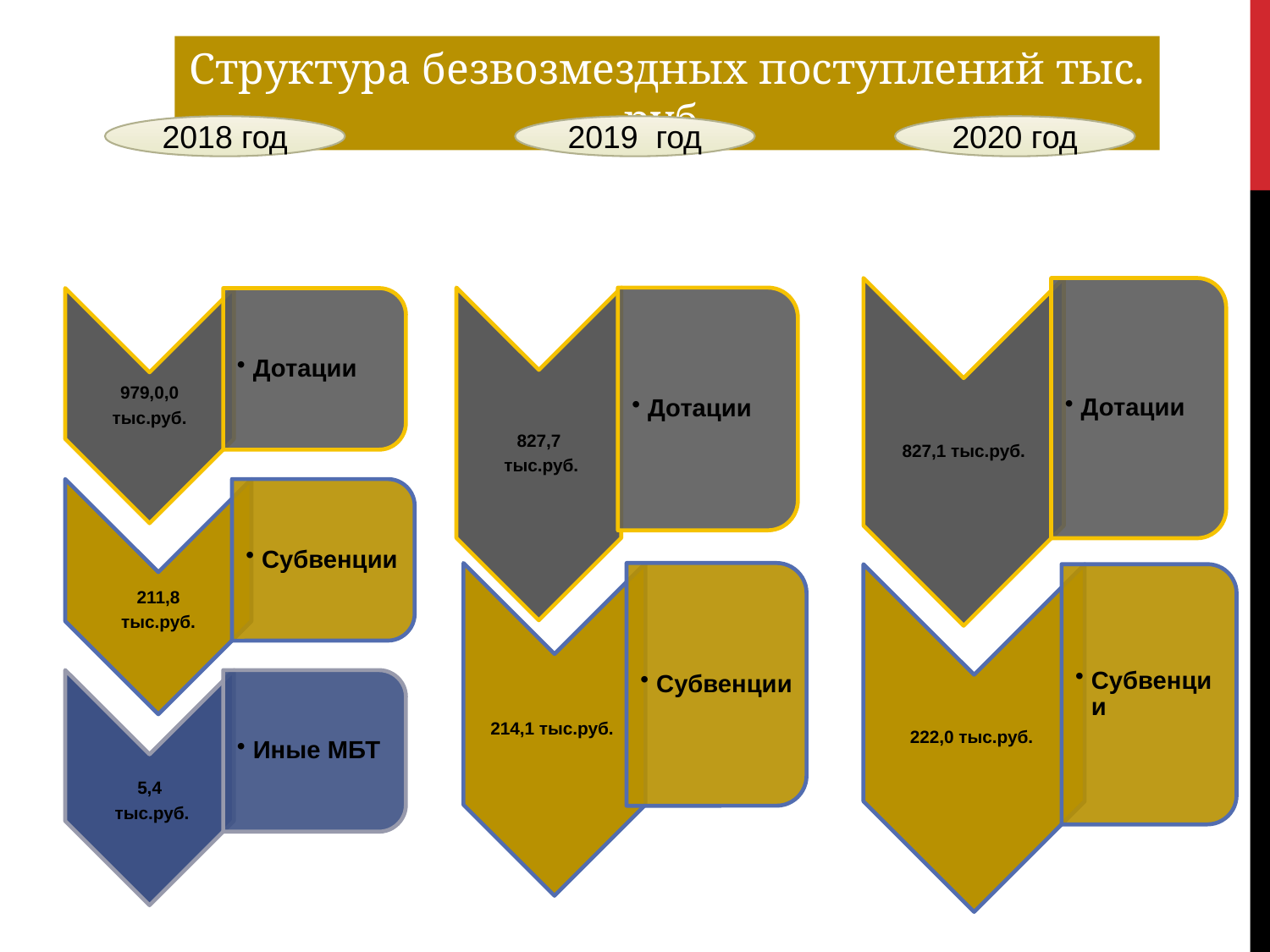
In the 2018 год diagram, what value is shown for Дотации? 979,0,0 тыс.руб. In the 2019 год diagram, what value is shown for Субвенции? 214,1 тыс.руб. In the 2020 год diagram, what value is shown for Субвенции? 222,0 тыс.руб. In the 2019 год diagram, which category has the largest value? Дотации In the 2020 год diagram, what value is shown for Дотации? 827,1 тыс.руб. In the 2018 год diagram, what value is shown for Субвенции? 211,8 тыс.руб. In the 2018 год diagram, which category has the smallest value? Иные МБТ Which is larger: Субвенции in the 2020 год diagram or Субвенции in the 2019 год diagram? 2020 год In the 2019 год diagram, what value is shown for Дотации? 827,7 тыс.руб. How many categories are shown in the 2018 год diagram? 3 What is the difference between Субвенции in the 2020 год diagram and Субвенции in the 2019 год diagram? 7,9 тыс.руб. In the 2018 год diagram, what value is shown for Иные МБТ? 5,4 тыс.руб.